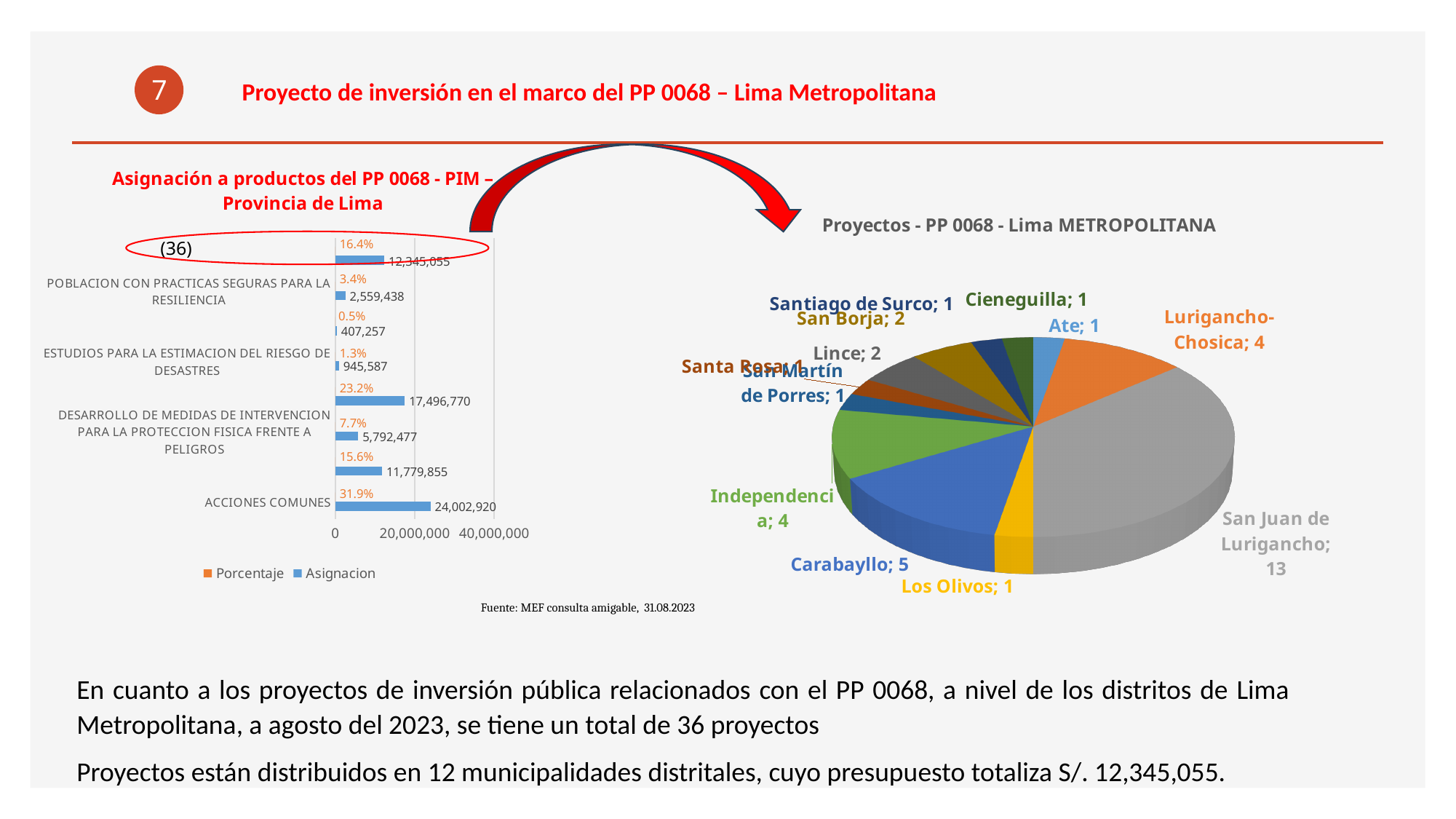
In the pie chart 'Proyectos - PP 0068 - Lima METROPOLITANA', how many projects does Carabayllo have? 5 What type of chart is the 'Asignación a productos del PP 0068 - PIM – Provincia de Lima' chart on the left? Bar chart In the bar chart on the left, what are the two legend entries? Porcentaje and Asignacion In the pie chart 'Proyectos - PP 0068 - Lima METROPOLITANA', which district has the most projects? San Juan de Lurigancho In the bar chart on the left, what is the Porcentaje value for ACCIONES COMUNES? 31.9% In the pie chart 'Proyectos - PP 0068 - Lima METROPOLITANA', which has more projects, Independencia or Lince? Independencia In the pie chart 'Proyectos - PP 0068 - Lima METROPOLITANA', how many projects does San Juan de Lurigancho have? 13 In the pie chart 'Proyectos - PP 0068 - Lima METROPOLITANA', what is the difference between the number of projects in San Juan de Lurigancho and Carabayllo? 8 In the pie chart 'Proyectos - PP 0068 - Lima METROPOLITANA', how many districts (slices) are shown? 12 In the bar chart on the left, what is the Asignacion value for ACCIONES COMUNES? 24,002,920 What type of chart is the 'Proyectos - PP 0068 - Lima METROPOLITANA' chart on the right? Pie chart In the bar chart on the left, how many series does the legend list? 2